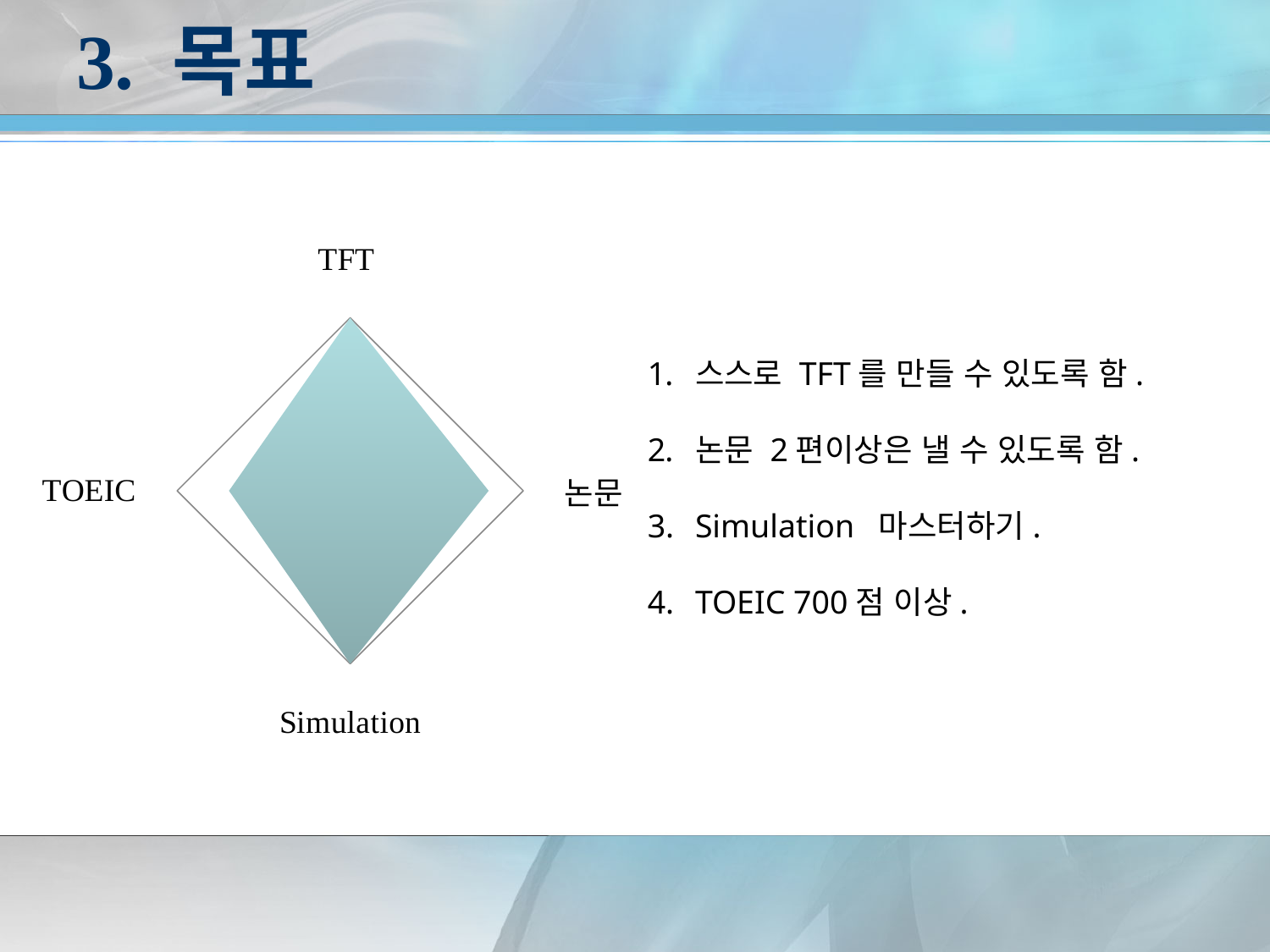
Which category is labelled at the bottom of the radar chart? Simulation Which is larger on the radar chart, the value for Simulation or the value for 논문? Simulation Which is larger on the radar chart, the value for TFT or the value for TOEIC? TFT Which category is labelled at the top of the radar chart? TFT What kind of chart is shown on the slide? radar chart Which is larger on the radar chart, the value for TFT or the value for 논문? TFT How many categories (axes) does the radar chart have? 4